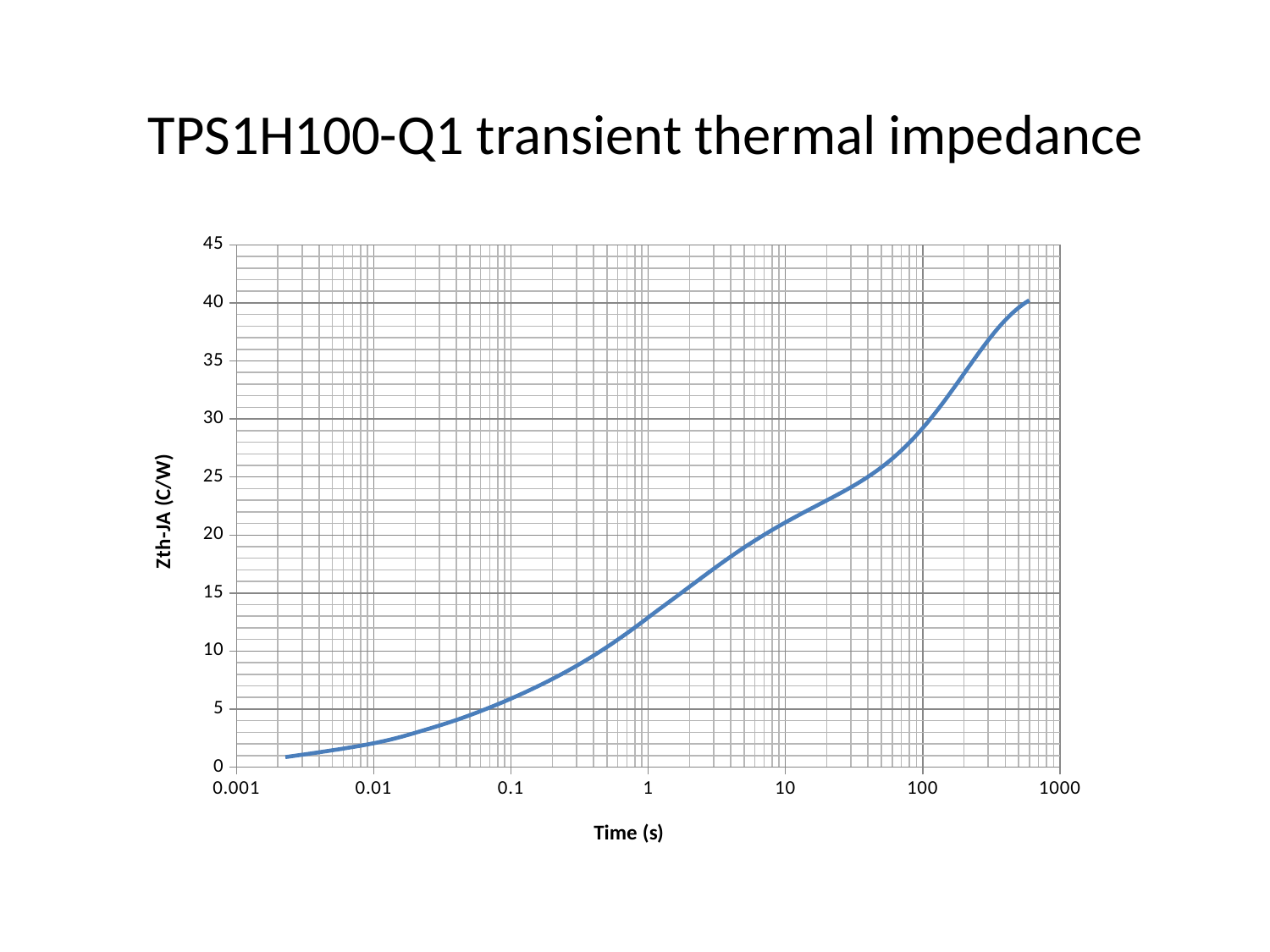
Is the value at 10 s larger or smaller than the value at 1 s? larger What is the title of the chart? TPS1H100-Q1 transient thermal impedance Is the highest value reached by the curve greater or less than 35? greater What is the label of the y axis? Zth-JA (C/W) Does the plotted value rise or fall as time increases along the x axis? rise Is the value at a time of 1 s greater or less than 15? less Is the value at a time of 10 s greater or less than 20? greater What kind of chart is shown on the slide? line chart